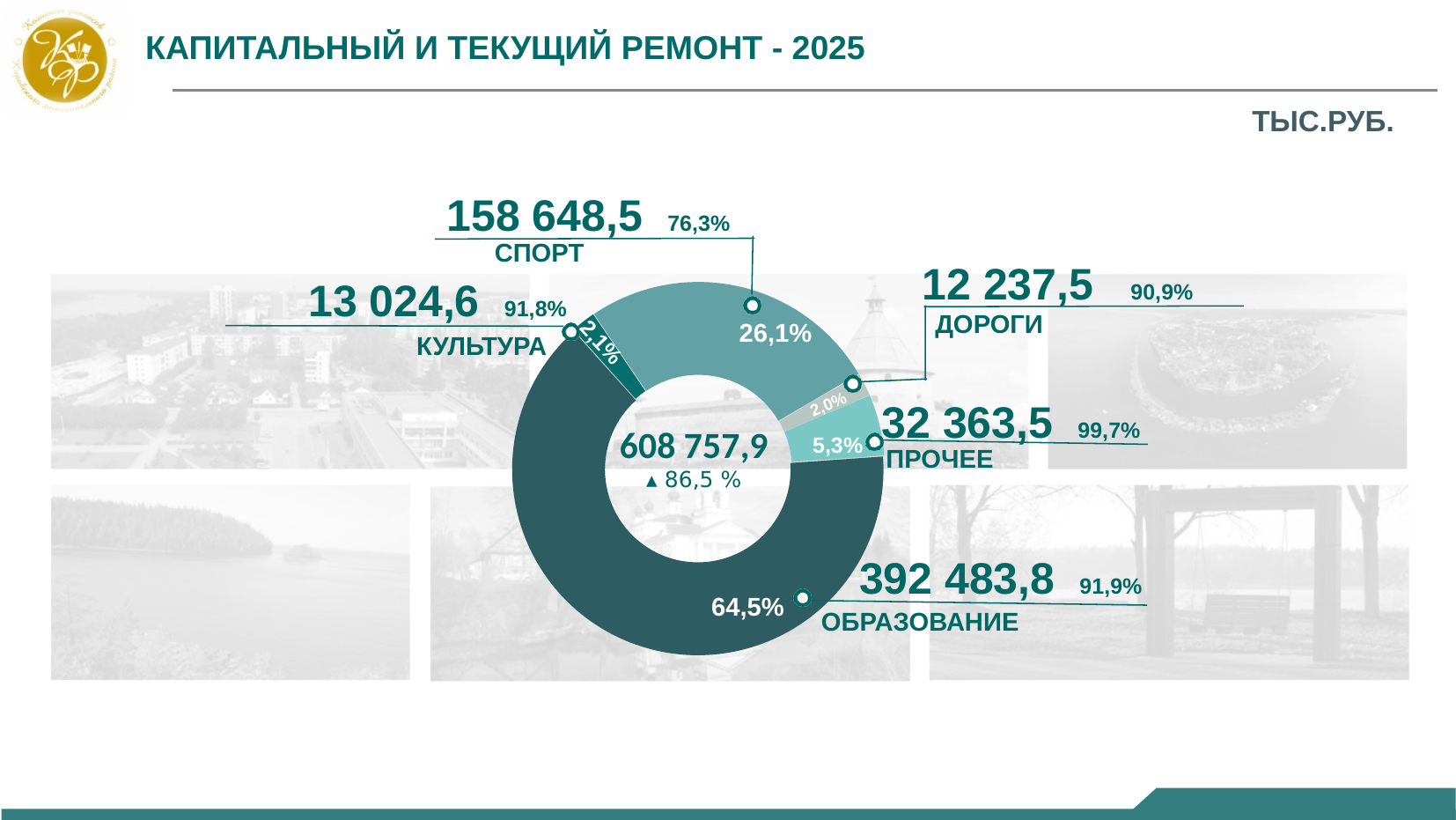
Which is larger, the value for СПОРТ or the value for ПРОЧЕЕ? СПОРТ Which category has the smallest value? ДОРОГИ What share of the donut does ПРОЧЕЕ take? 5,3% What total value is shown in the centre of the donut chart? 608 757,9 What is the value for ДОРОГИ? 12 237,5 How many categories does the donut chart show? 5 What is the value for СПОРТ? 158 648,5 What kind of chart is shown on the slide? Donut (pie) chart Which category has the largest value? ОБРАЗОВАНИЕ What share of the donut does КУЛЬТУРА take? 2,1% What is the difference between the values for КУЛЬТУРА and ДОРОГИ? 787,1 What is the value for ОБРАЗОВАНИЕ? 392 483,8